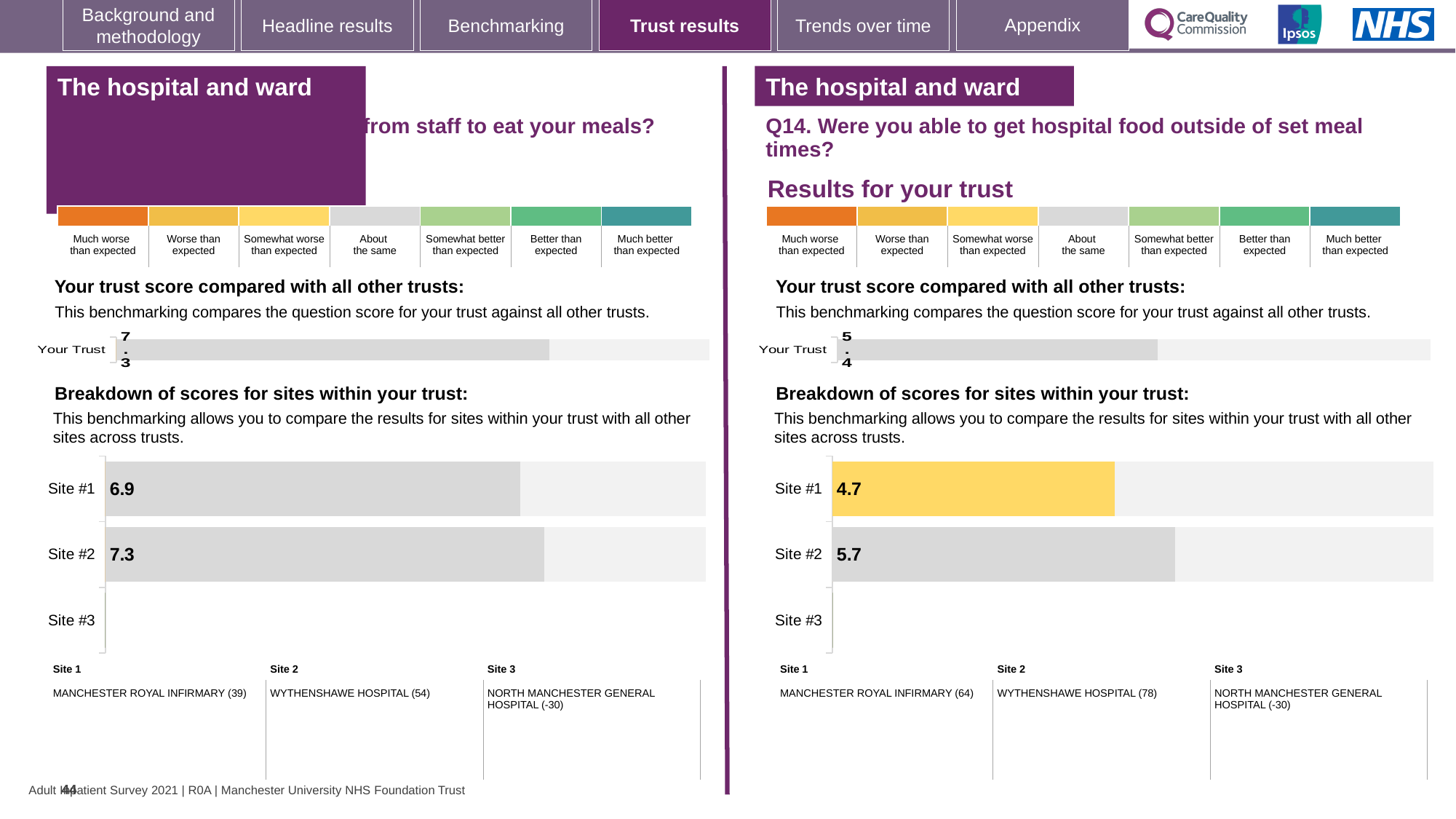
What type of chart is used for the site breakdown on the right-hand side for Q14? Bar chart On the right-hand chart for Q14, what is the 'Your Trust' score? 5.4 On the right-hand chart for Q14, which site has the higher score, Site #1 or Site #2? Site #2 On the right-hand chart for Q14, what is the score for Site #2? 5.7 On the left-hand chart, what is the score for Site #2? 7.3 On the right-hand chart for Q14, what is the difference between the Site #2 and Site #1 scores? 1.0 On the right-hand chart for Q14, what is the score for Site #1? 4.7 On the left-hand chart, what is the difference between the Site #2 and Site #1 scores? 0.4 On the left-hand chart, what is the score for Site #1? 6.9 How many site categories are listed on the right-hand site breakdown chart for Q14? 3 On the left-hand chart, which site has the lower score, Site #1 or Site #2? Site #1 On the left-hand chart, what is the 'Your Trust' score? 7.3